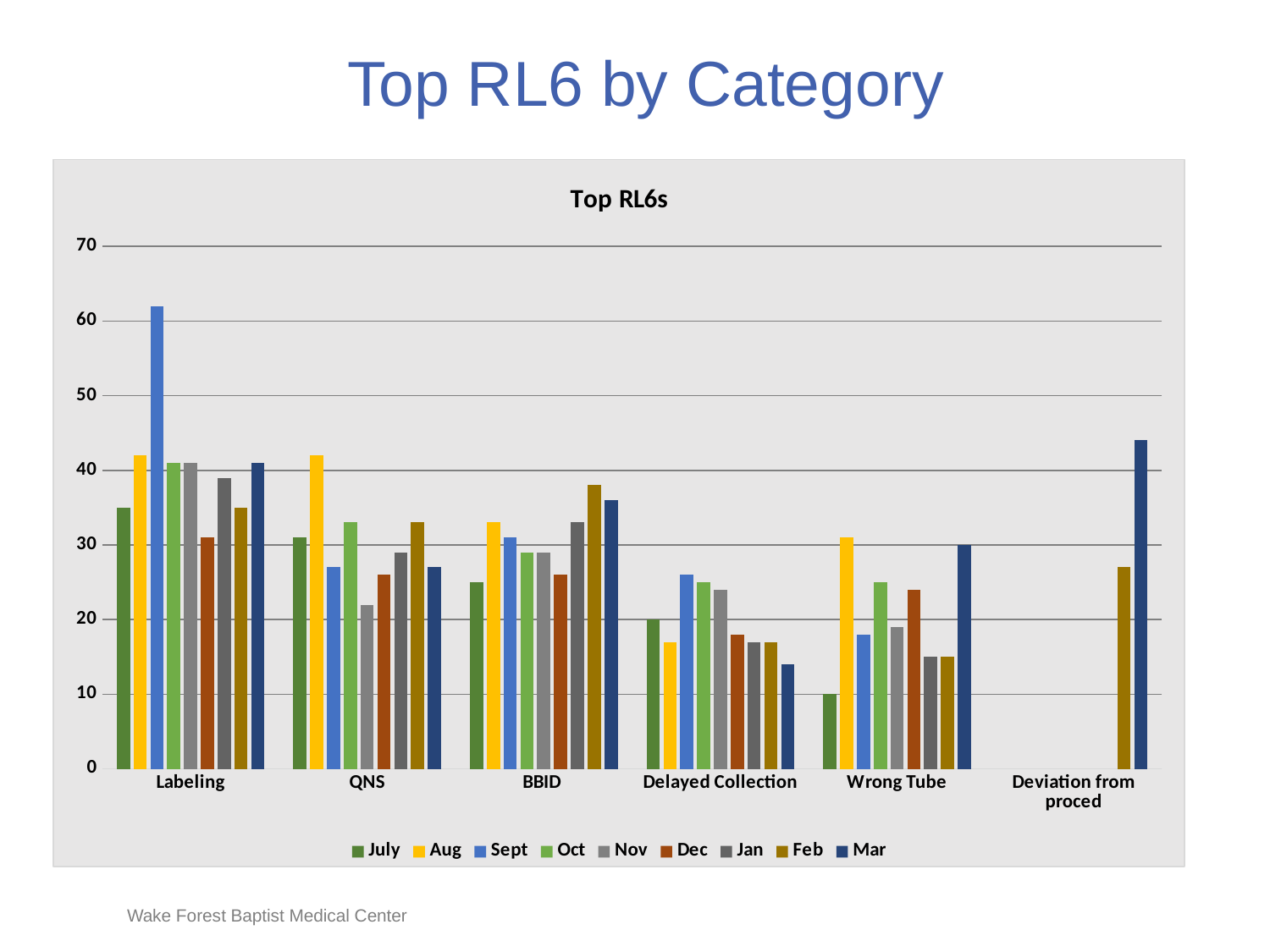
Is the July value for Wrong Tube greater or less than 20? less Is the Sept value for Labeling greater or less than 60? greater Which month has the lowest bar in the Wrong Tube category? July Which is larger: the Sept value for Labeling or the Aug value for QNS? Sept value for Labeling What kind of chart is shown on the slide? bar chart How many series does the legend list? 9 What is the title of the chart? Top RL6s Is the Mar value for Deviation from proced greater or less than 40? greater Which is larger for Delayed Collection: the Sept value or the Mar value? Sept Which month has the highest bar in the Deviation from proced category? Mar Which month has the highest bar in the Labeling category? Sept How many categories are shown on the x axis? 6